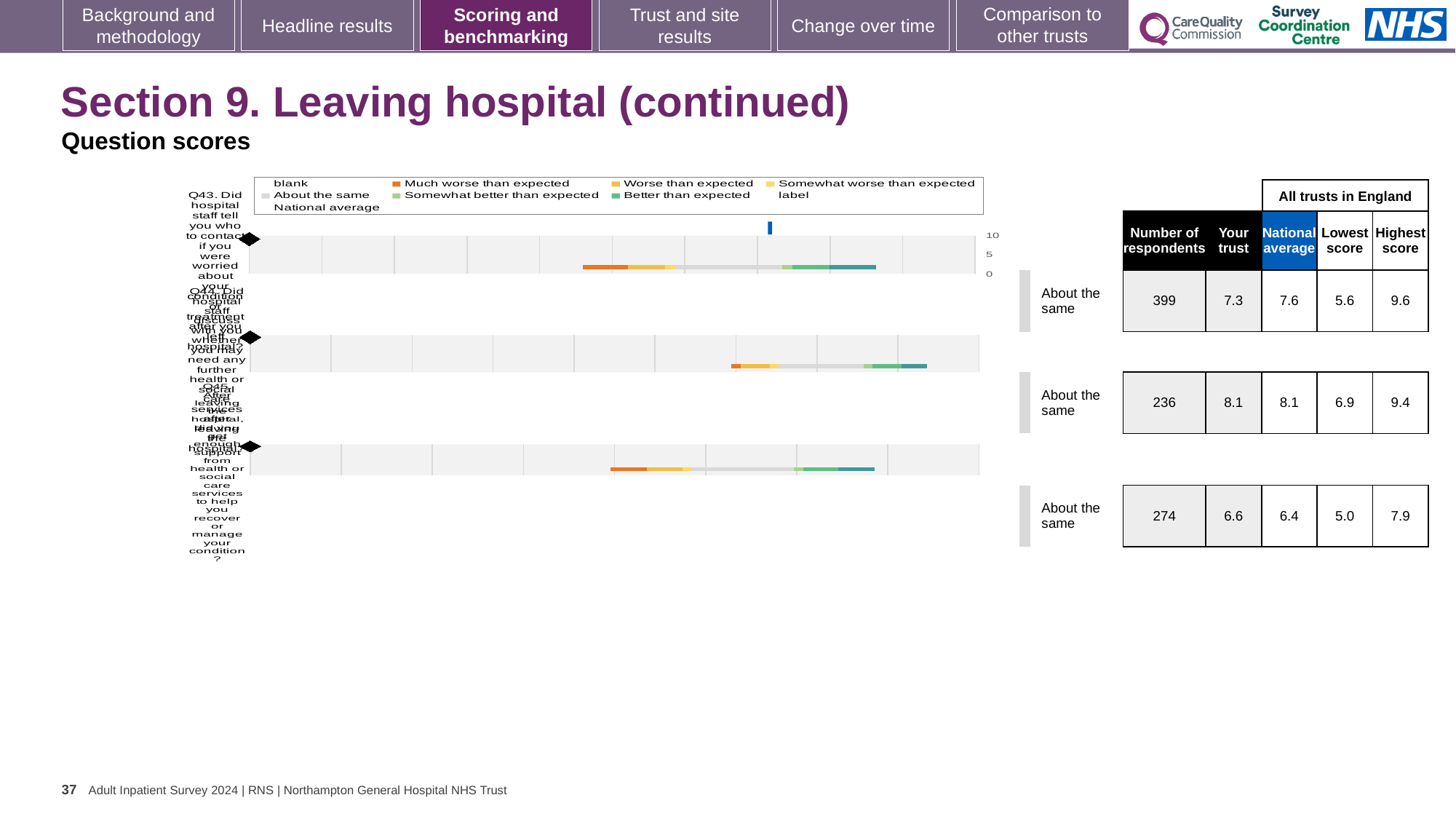
Which colour in the legend represents 'Much worse than expected'? orange For Q45, which is larger: the 'Your trust' score or the national average? Your trust How many questions (rows) are plotted in the chart? 3 What kind of chart is shown on the slide? bar chart Which question has the lowest 'Your trust' score? Q45 For Q43, what is the difference between the highest score and the lowest score across all trusts in England? 4.0 How many respondents answered Q45 (the third row)? 274 What benchmark category is shown for Q44? About the same What is the national average score for Q44 (the second row)? 8.1 What is the 'Your trust' score for Q43 (the first row)? 7.3 Which question has the highest 'Your trust' score? Q44 Is the 'Your trust' score for Q43 greater or less than 5? greater